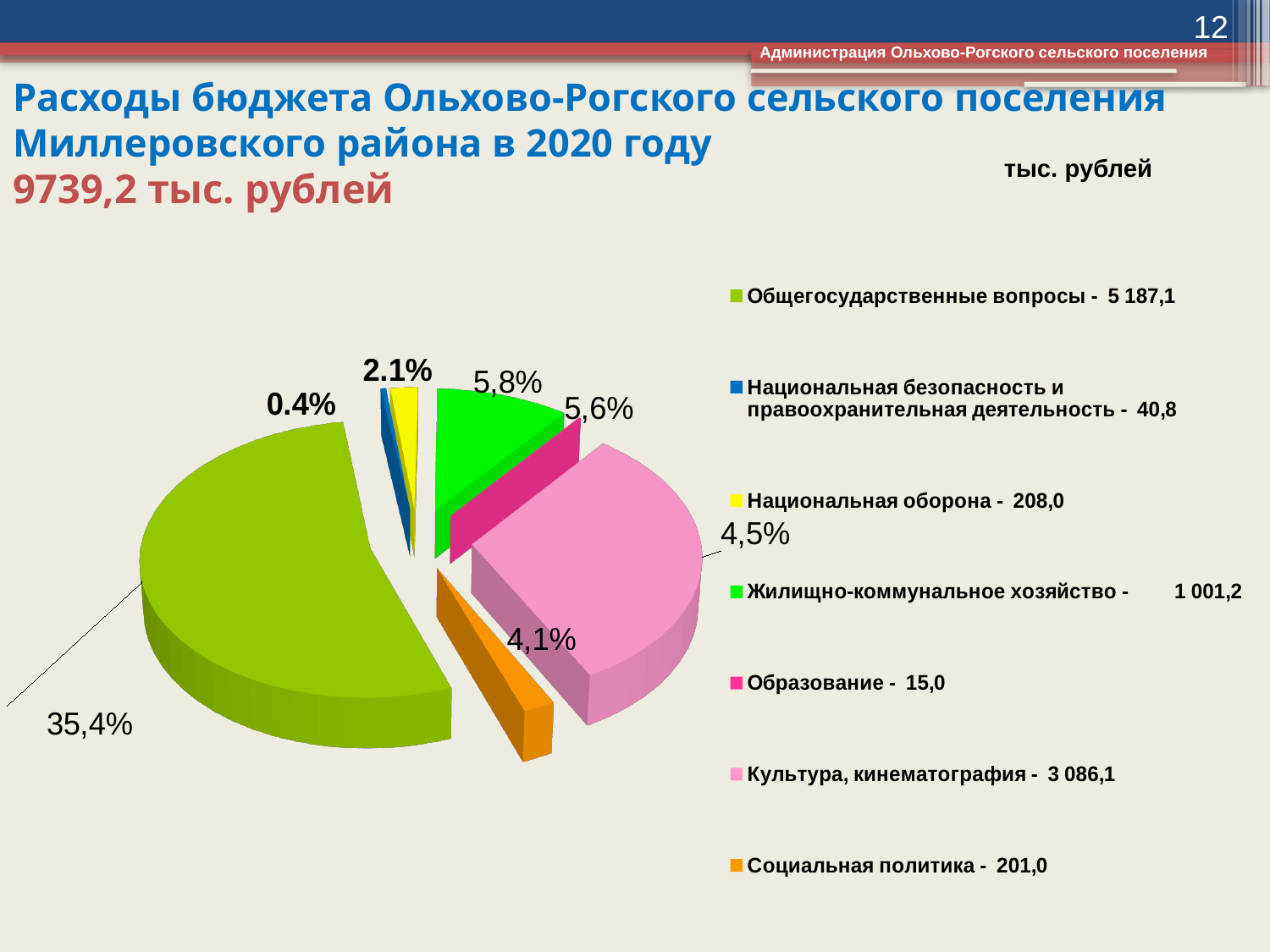
What is the difference between Национальная оборона and Социальная политика? 7,0 What total budget expenditure is stated in the slide title? 9739,2 тыс. рублей What is the value for Национальная оборона? 208,0 Which is larger: Культура, кинематография or Жилищно-коммунальное хозяйство? Культура, кинематография What is the difference between Общегосударственные вопросы and Культура, кинематография? 2 101,0 How many categories does the pie chart's legend list? 7 Which category has the largest value? Общегосударственные вопросы What is the value for Жилищно-коммунальное хозяйство? 1 001,2 What is the value for Общегосударственные вопросы in the legend? 5 187,1 Which category has the smallest value? Образование What kind of chart is shown on the slide? pie chart What is the value for Культура, кинематография? 3 086,1